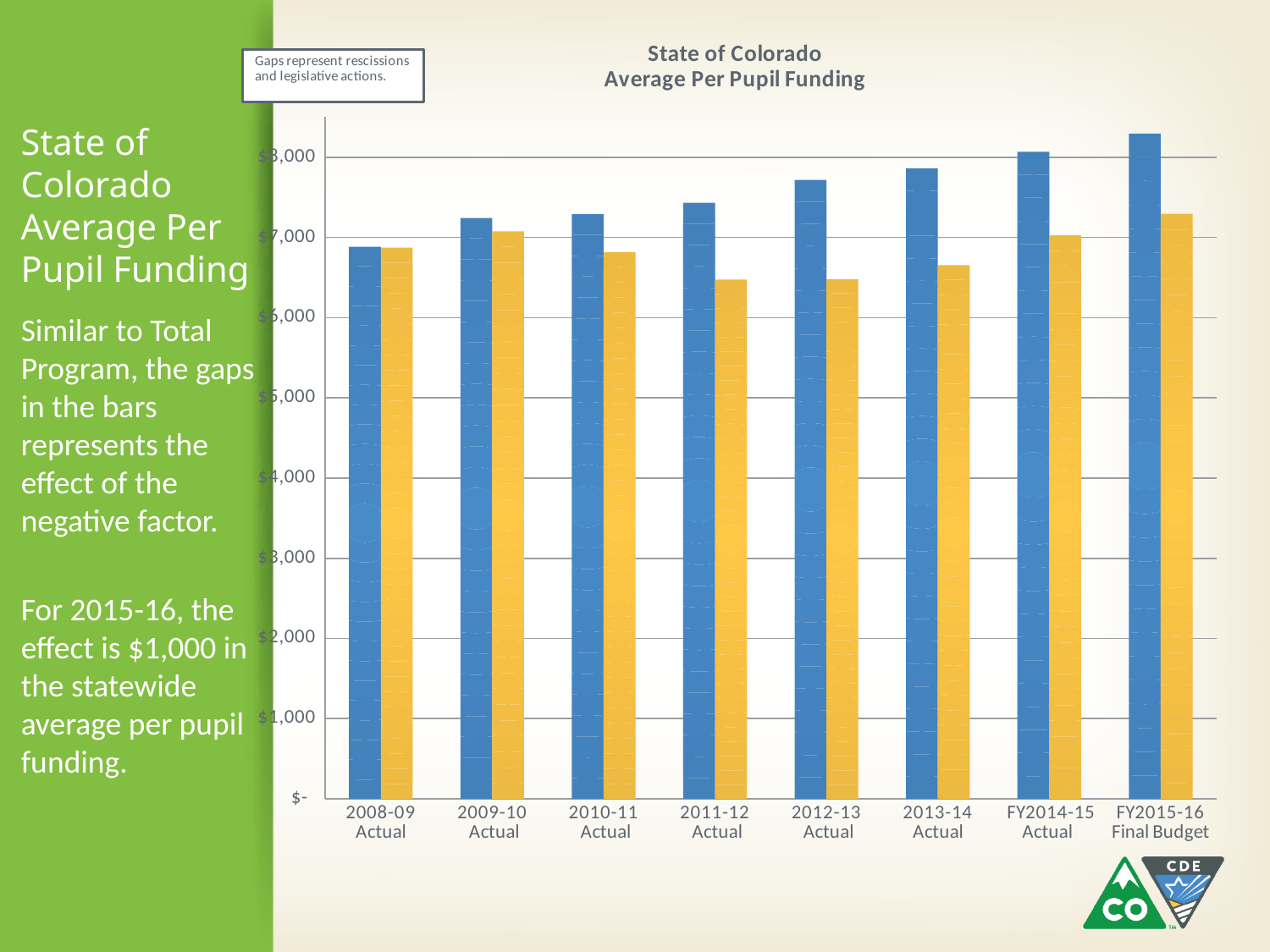
Is the yellow bar for 2011-12 Actual greater or less than $7,000? less How many bars are plotted for each fiscal year category? 2 Which fiscal year has the shortest blue bar? 2008-09 Actual In 2011-12 Actual, which bar is taller, the blue bar or the yellow bar? the blue bar Do the blue bars rise or fall from 2008-09 Actual to FY2015-16 Final Budget? rise Which fiscal year has the tallest yellow bar? FY2015-16 Final Budget Is the blue bar for 2008-09 Actual greater or less than $7,000? less How many fiscal year categories are shown on the x axis of the chart? 8 What kind of chart is shown on the slide? bar chart Which fiscal year has the tallest blue bar? FY2015-16 Final Budget Is the blue bar for FY2014-15 Actual greater or less than $8,000? greater What is the title of the chart? State of Colorado Average Per Pupil Funding